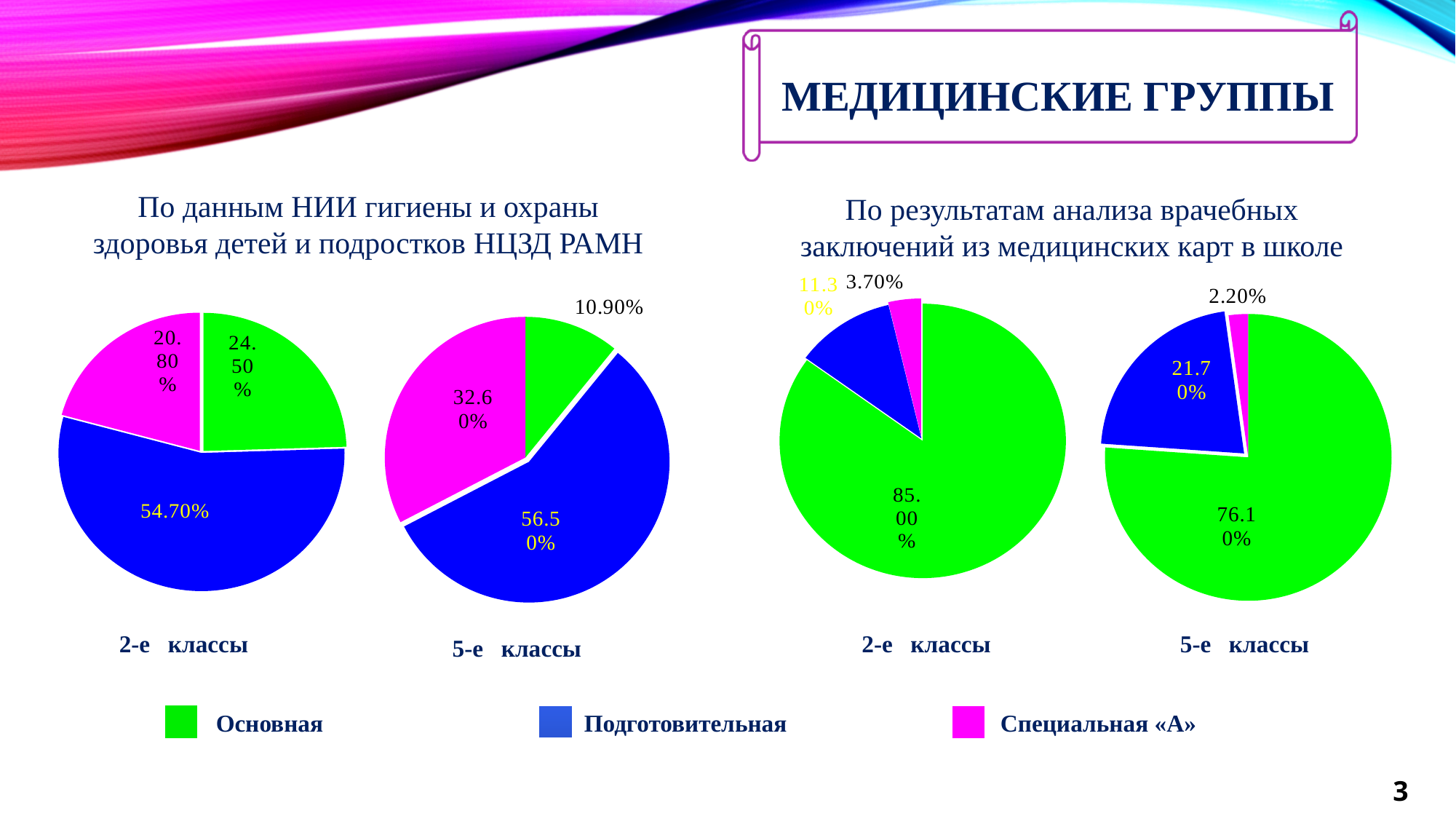
In the second pie chart from the left (НИИ data, 5-е классы), what is the share for Специальная «А»? 32.60% In the second pie chart from the left (НИИ data, 5-е классы), which group has the largest share? Подготовительная In the leftmost pie chart (НИИ data, 2-е классы), what is the share for Подготовительная? 54.70% What is the difference between the Основная share in the rightmost pie chart (5-е классы, school data) and the Основная share in the second pie chart from the left (5-е классы, НИИ data)? 65.20% In the leftmost pie chart (НИИ data, 2-е классы), what is the share for Основная? 24.50% In the rightmost pie chart (school medical records, 5-е классы), what is the share for Специальная «А»? 2.20% How many groups does the legend at the bottom of the slide list? 3 In the rightmost pie chart (school medical records, 5-е классы), what is the share for Подготовительная? 21.70% In the third pie chart from the left (school medical records, 2-е классы), what is the share for Основная? 85.00% How many pie charts are shown on the slide? 4 In the third pie chart from the left (school medical records, 2-е классы), which group has the smallest share? Специальная «А» Which is larger: the Подготовительная share in the leftmost pie chart (НИИ, 2-е классы) or in the third pie chart from the left (school, 2-е классы)? Leftmost (НИИ, 2-е классы)